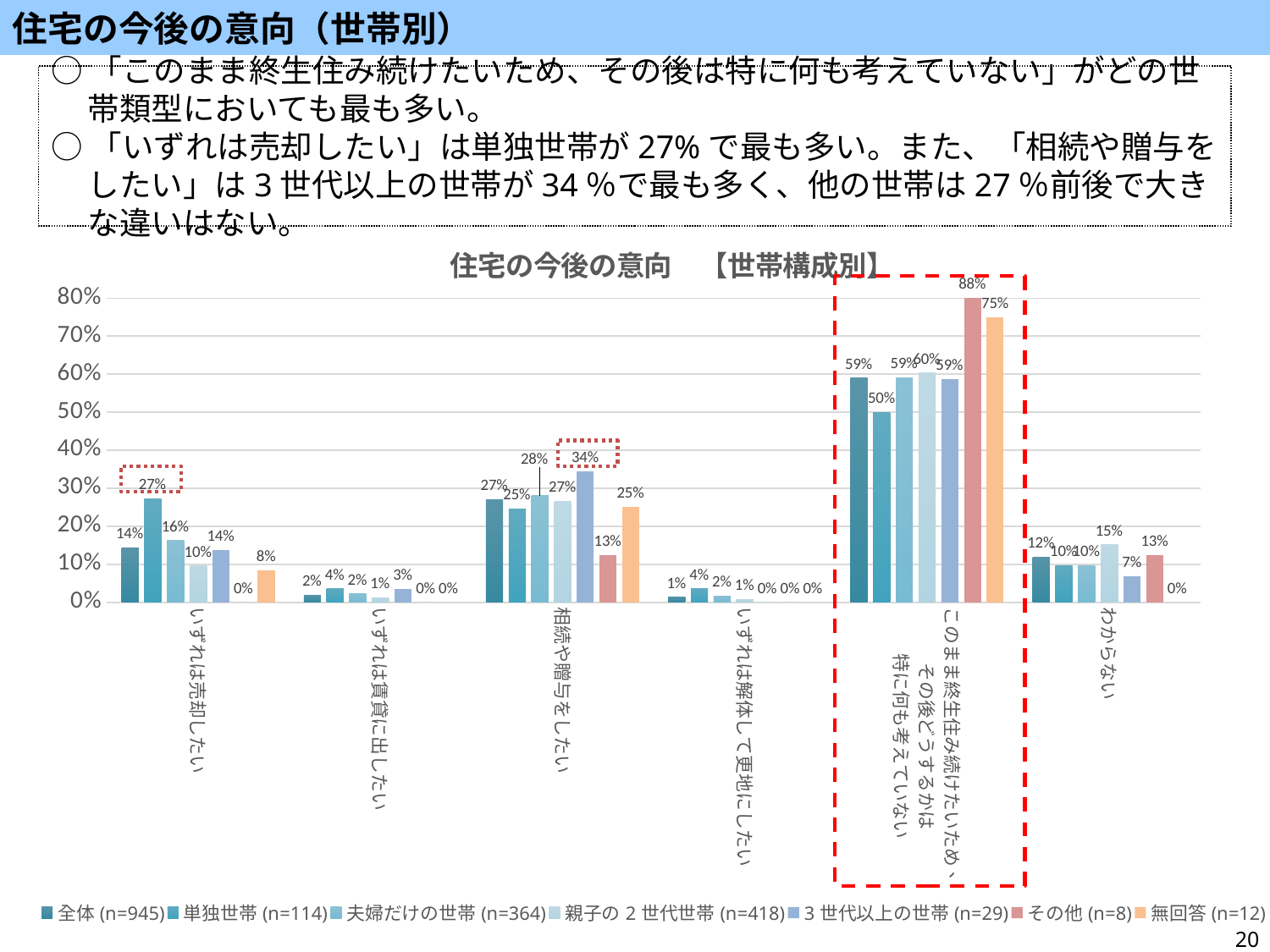
What is the difference between 単独世帯 (n=114) and 全体 (n=945) in the いずれは売却したい category? 13% What is the value for その他 (n=8) in the このまま終生住み続けたいため、その後どうするかは特に何も考えていない category? 88% Which series has the lowest value in the わからない category? 無回答 (n=12) Is the value for 無回答 (n=12) in the このまま終生住み続けたいため、その後どうするかは特に何も考えていない category greater or less than 70%? greater What is the value for 単独世帯 (n=114) in the いずれは売却したい category? 27% Which is larger in the 相続や贈与をしたい category: 3世代以上の世帯 (n=29) or その他 (n=8)? 3世代以上の世帯 (n=29) How many categories are shown on the x axis? 6 How many series does the legend list? 7 What type of chart is shown on the slide? bar chart What is the value for 3世代以上の世帯 (n=29) in the 相続や贈与をしたい category? 34% What is the title of the chart? 住宅の今後の意向 【世帯構成別】 Which series has the highest value in the このまま終生住み続けたいため、その後どうするかは特に何も考えていない category? その他 (n=8)